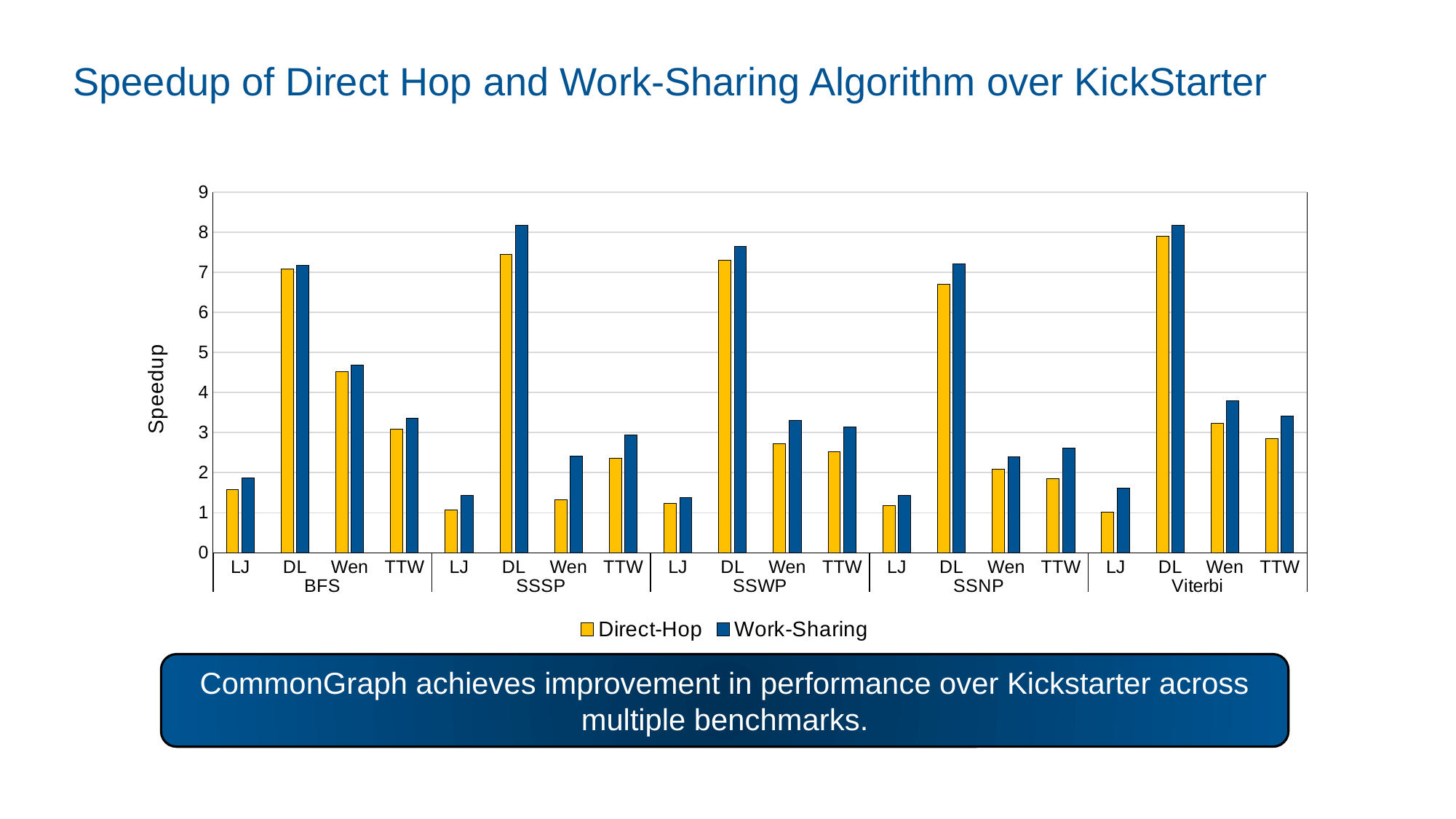
What kind of chart is shown on the slide? bar chart What are the two series named in the legend? Direct-Hop and Work-Sharing How many input graphs are shown within each algorithm group? 4 Is the Work-Sharing value for DL under SSSP greater or less than 8? greater Is the Direct-Hop value for Wen under BFS greater or less than 4? greater Is the Direct-Hop value for LJ under SSSP greater or less than 2? less How many algorithm groups (BFS, SSSP, etc.) are shown along the x axis? 5 For Wen under SSSP, which series has the larger value, Direct-Hop or Work-Sharing? Work-Sharing What is the label on the y axis? Speedup How many series does the legend list? 2 Which has the larger Direct-Hop value: DL under BFS or DL under SSNP? DL under BFS